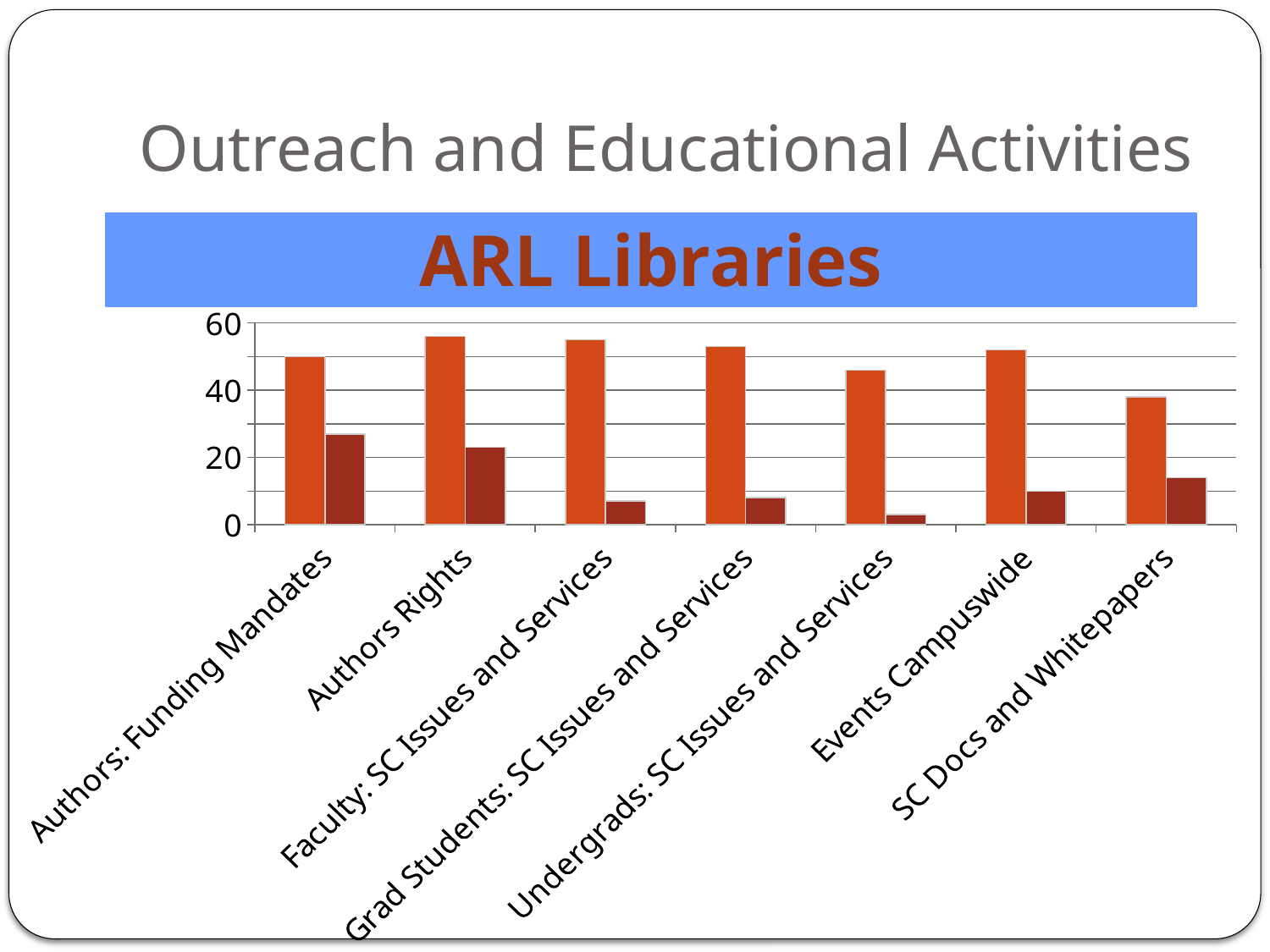
What is the title shown above the chart? ARL Libraries What kind of chart is shown on the slide? bar chart Is the dark red bar for Authors: Funding Mandates greater or less than 20? greater Which category has the larger orange bar, Authors Rights or SC Docs and Whitepapers? Authors Rights Is the orange bar for Authors Rights greater or less than 40? greater Among the dark red (shorter) bars, which category has the lowest value? Undergrads: SC Issues and Services Among the orange (taller) bars, which category has the lowest value? SC Docs and Whitepapers Is the orange bar for SC Docs and Whitepapers greater or less than 40? less How many categories are shown on the x axis of the chart? 7 For Events Campuswide, which bar is larger, the orange bar or the dark red bar? the orange bar How many data series are plotted for each category in the chart? 2